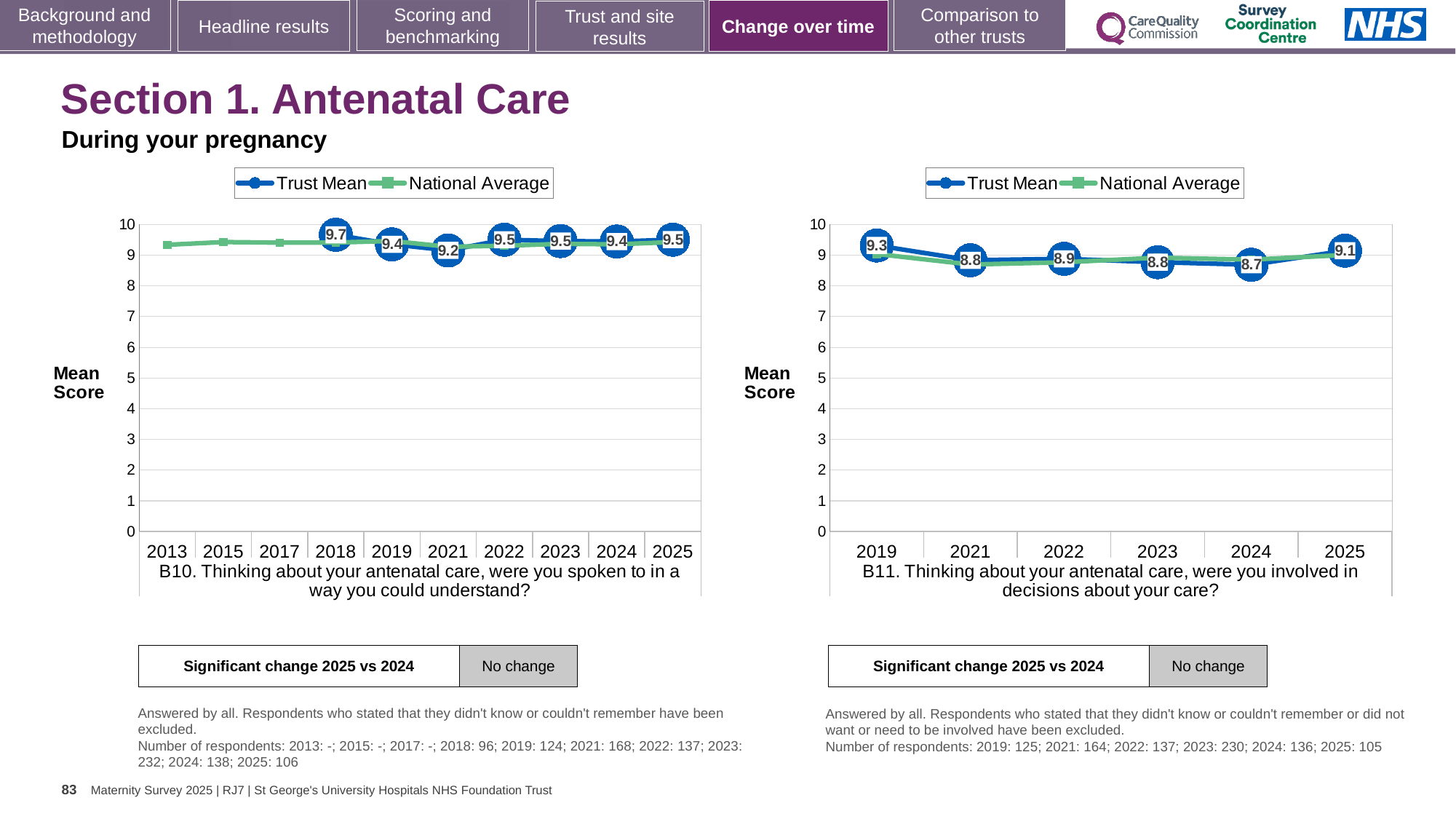
How many series does the legend of the B10 chart (left) list? 2 In the B10 chart (left), which year has the lowest Trust Mean? 2021 In the B10 chart (left), what is the Trust Mean for 2021? 9.2 What kind of chart is the B10 chart (left)? line chart In the B11 chart (right), which year has the highest Trust Mean? 2019 How many years are shown on the x axis of the B11 chart (right)? 6 In the B10 chart (left), what is the difference between the Trust Mean for 2018 and 2021? 0.5 In the B11 chart (right), what is the Trust Mean for 2025? 9.1 In the B11 chart (right), which year has the lowest Trust Mean? 2024 In the B10 chart (left), which year has the highest Trust Mean? 2018 In the B11 chart (right), is the Trust Mean for 2019 larger or smaller than for 2024? larger In the B10 chart (left), what is the Trust Mean for 2018? 9.7